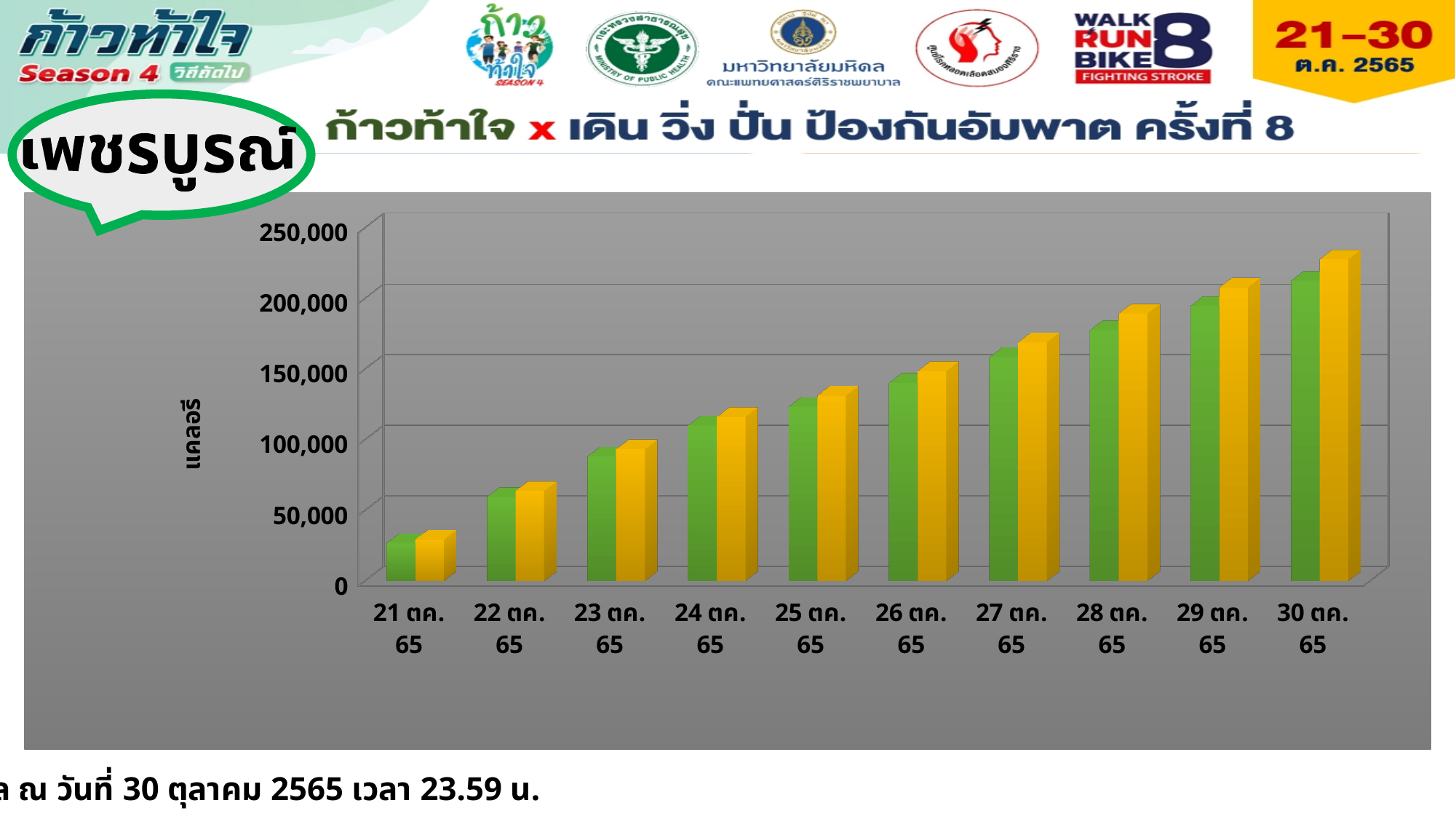
Is the green bar for 28 ตค. 65 greater or less than 200,000? less Is the green bar for 21 ตค. 65 greater or less than 50,000? less Is the yellow bar for 25 ตค. 65 greater or less than 100,000? greater Do the values rise or fall from 21 ตค. 65 to 30 ตค. 65? rise Which date has a larger value, 21 ตค. 65 or 30 ตค. 65? 30 ตค. 65 Which date has the highest bars in the chart? 30 ตค. 65 What is the label on the vertical axis of the chart? แคลอรี Which date has the lowest bars in the chart? 21 ตค. 65 How many dates are shown along the x axis of the chart? 10 What kind of chart is shown on the slide? bar chart